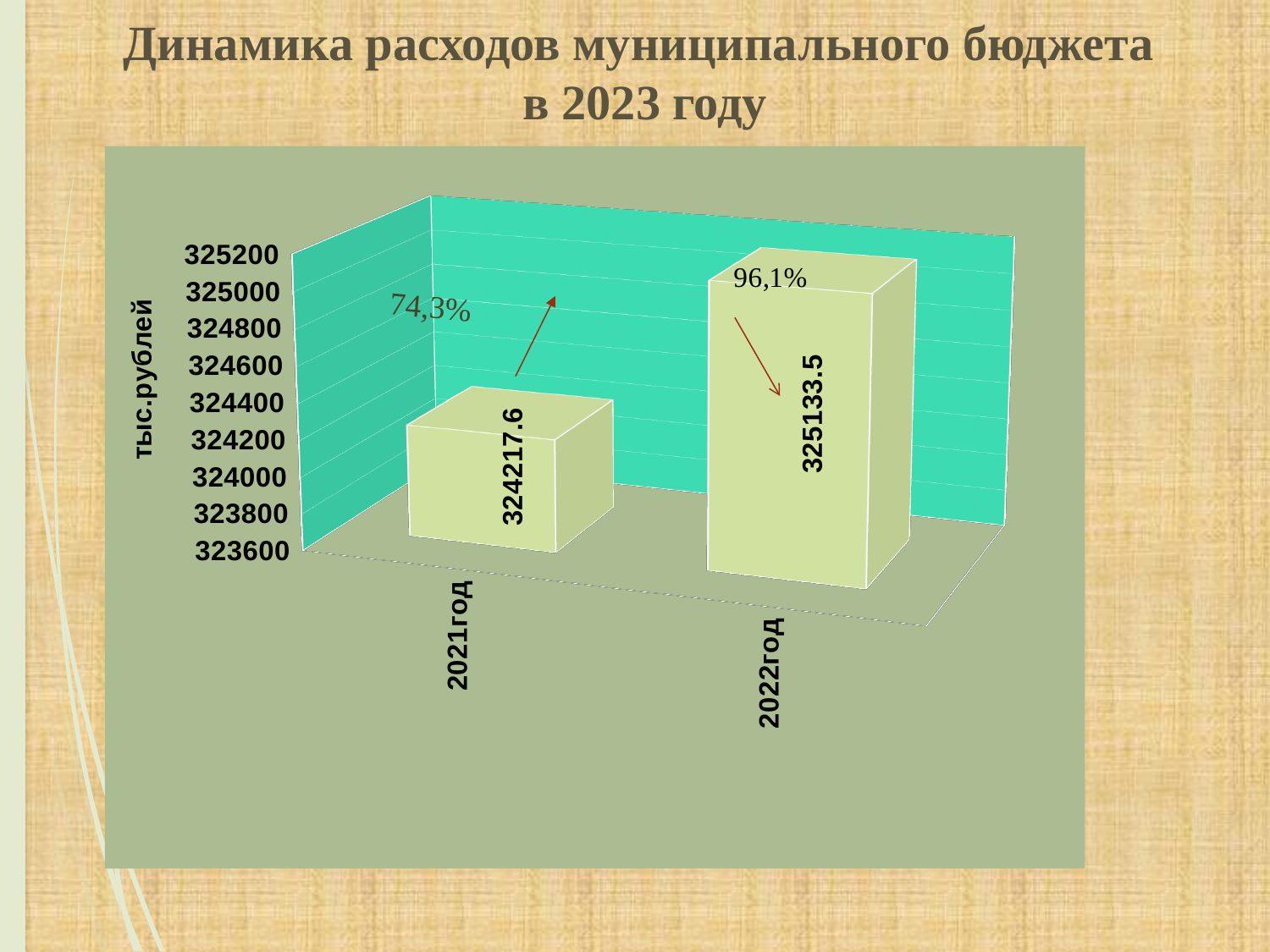
What is the value for 2021год? 324217.6 Do the values rise or fall from 2021год to 2022год? rise Which category has the highest value? 2022год What is the difference between the values for 2022год and 2021год? 915.9 What is the value for 2022год? 325133.5 Which is larger, the value for 2021год or the value for 2022год? 2022год Is the value for 2021год greater or less than 324400? less What is the label of the vertical axis? тыс.рублей Is the value for 2022год greater or less than 325000? greater What kind of chart is shown on the slide? bar chart Which category has the lowest value? 2021год How many categories are shown on the x axis? 2